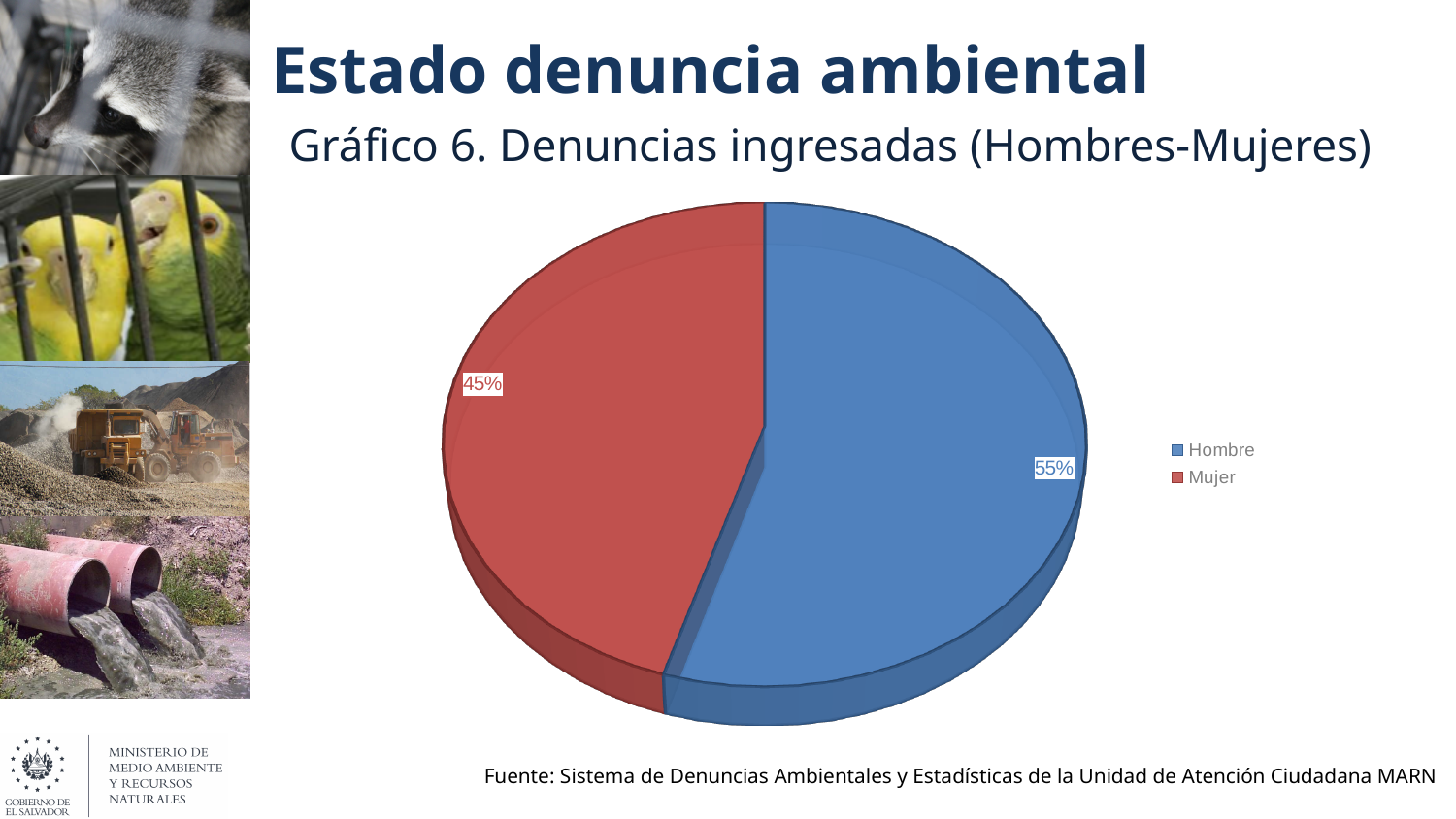
What is the title of the chart? Gráfico 6. Denuncias ingresadas (Hombres-Mujeres) What kind of chart is shown on the slide? Pie chart How many entries does the legend list? 2 How many categories does the pie chart have? 2 What colour is the Mujer slice? Red Which category has the smallest slice of the pie? Mujer What share of the pie does Mujer represent? 45% What is the difference in percentage points between the Hombre and Mujer slices? 10 percentage points What share of the pie does Hombre represent? 55% Which is larger, the Hombre slice or the Mujer slice? Hombre Which category has the largest slice of the pie? Hombre